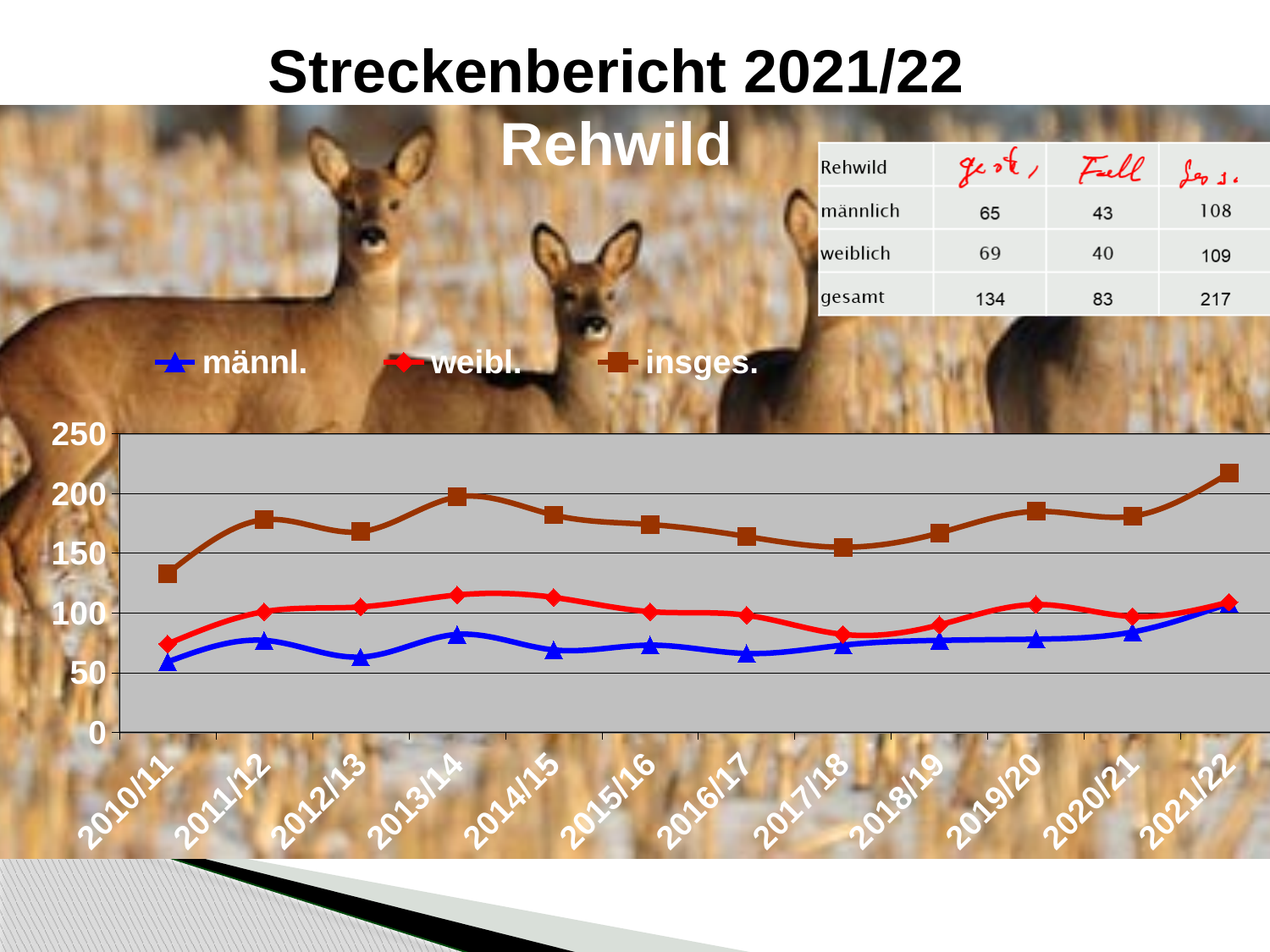
Does the insges. series rise or fall from 2017/18 to 2021/22? rise In which season does the insges. series reach its highest value? 2021/22 How many series does the chart legend list? 3 In which season does the insges. series have its lowest value? 2010/11 How many hunting seasons are plotted along the x axis of the chart? 12 Is the value for weibl. in 2010/11 greater or less than 100? less What kind of chart is shown on the slide? line chart Which is larger in 2013/14, the insges. value or the insges. value in 2017/18? 2013/14 What are the three legend entries of the chart? männl., weibl., insges. In which season does the männl. series reach its highest value? 2021/22 Is the value for insges. in 2010/11 greater or less than 150? less Is the value for insges. in 2021/22 greater or less than 200? greater